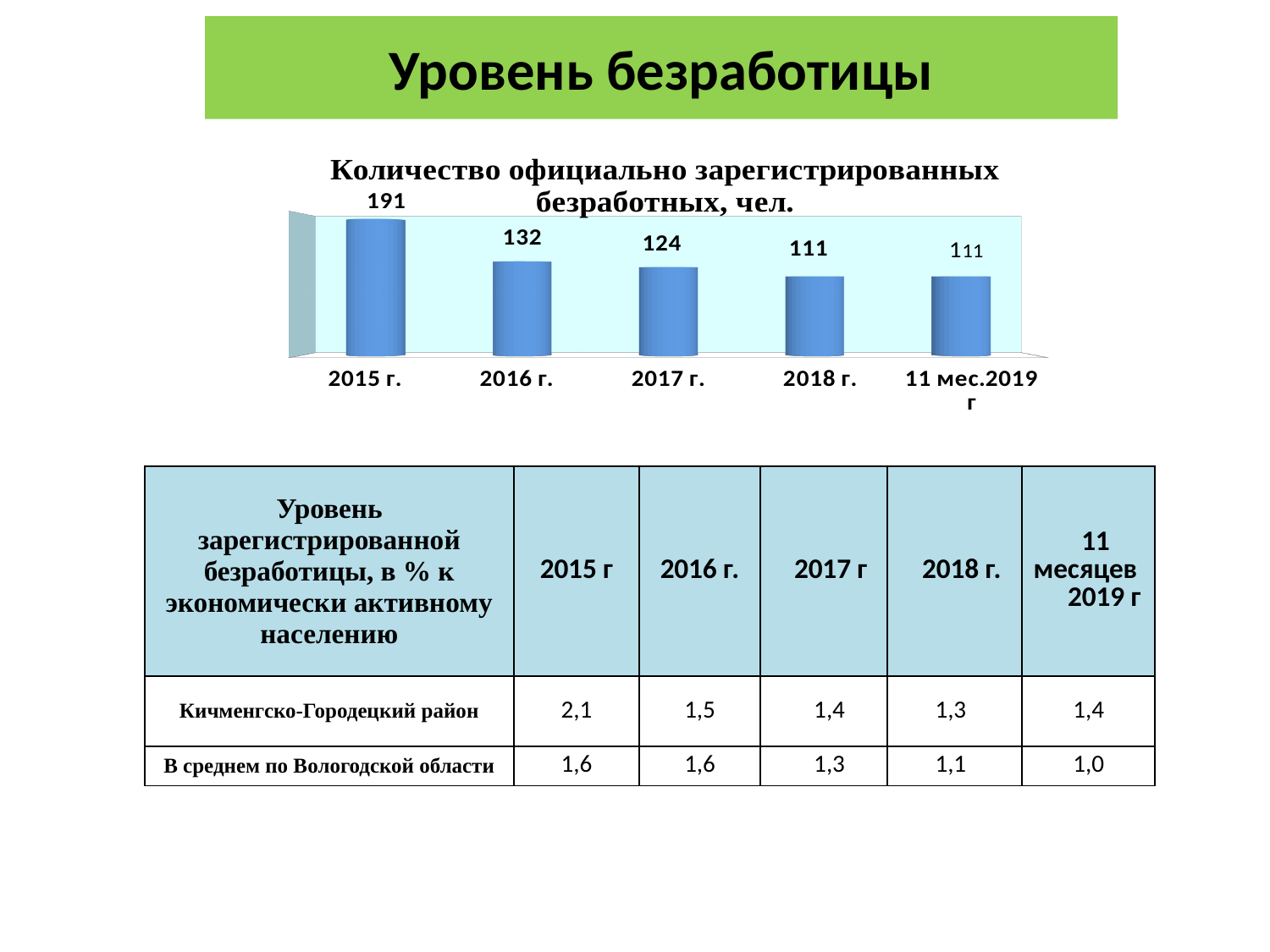
What kind of chart is used to show the number of registered unemployed people? Bar chart Which year has the highest number of registered unemployed people? 2015 г. How many categories (periods) are shown on the chart? 5 What is the number of officially registered unemployed people shown for 2015 г.? 191 Which is larger, the value for 2016 г. or the value for 2017 г.? 2016 г. What value does the chart show for 2018 г.? 111 Do the values on the chart generally rise or fall from 2015 г. to 11 мес.2019 г? Fall What value does the chart show for 2016 г.? 132 What is the difference between the values for 2015 г. and 2016 г.? 59 What value does the chart show for 2017 г.? 124 What value does the chart show for 11 мес.2019 г? 111 What is the difference between the values for 2017 г. and 2018 г.? 13